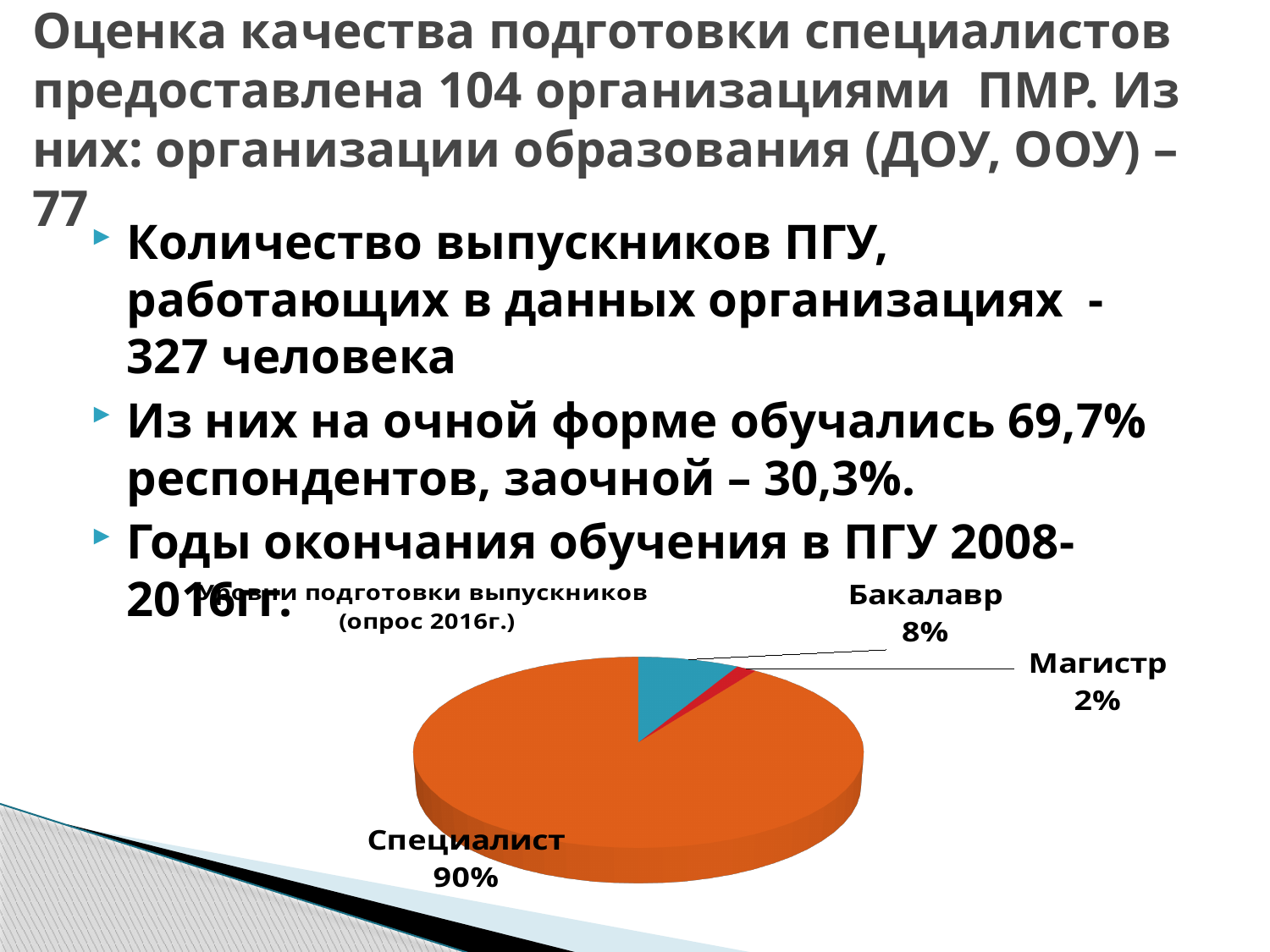
What colour is the Специалист slice of the pie? orange What share of the pie does Специалист hold? 90% Which category has the largest slice of the pie? Специалист What year is the survey in the chart title from? 2016 Which is larger, the share for Бакалавр or the share for Магистр? Бакалавр Which category has the smallest slice of the pie? Магистр How many slices does the pie chart have? 3 What share of the pie does Магистр hold? 2% What is the difference in percentage points between Специалист and Бакалавр? 82% What share of the pie does Бакалавр hold? 8% What kind of chart is shown on the slide? pie chart What is the difference in percentage points between Бакалавр and Магистр? 6%